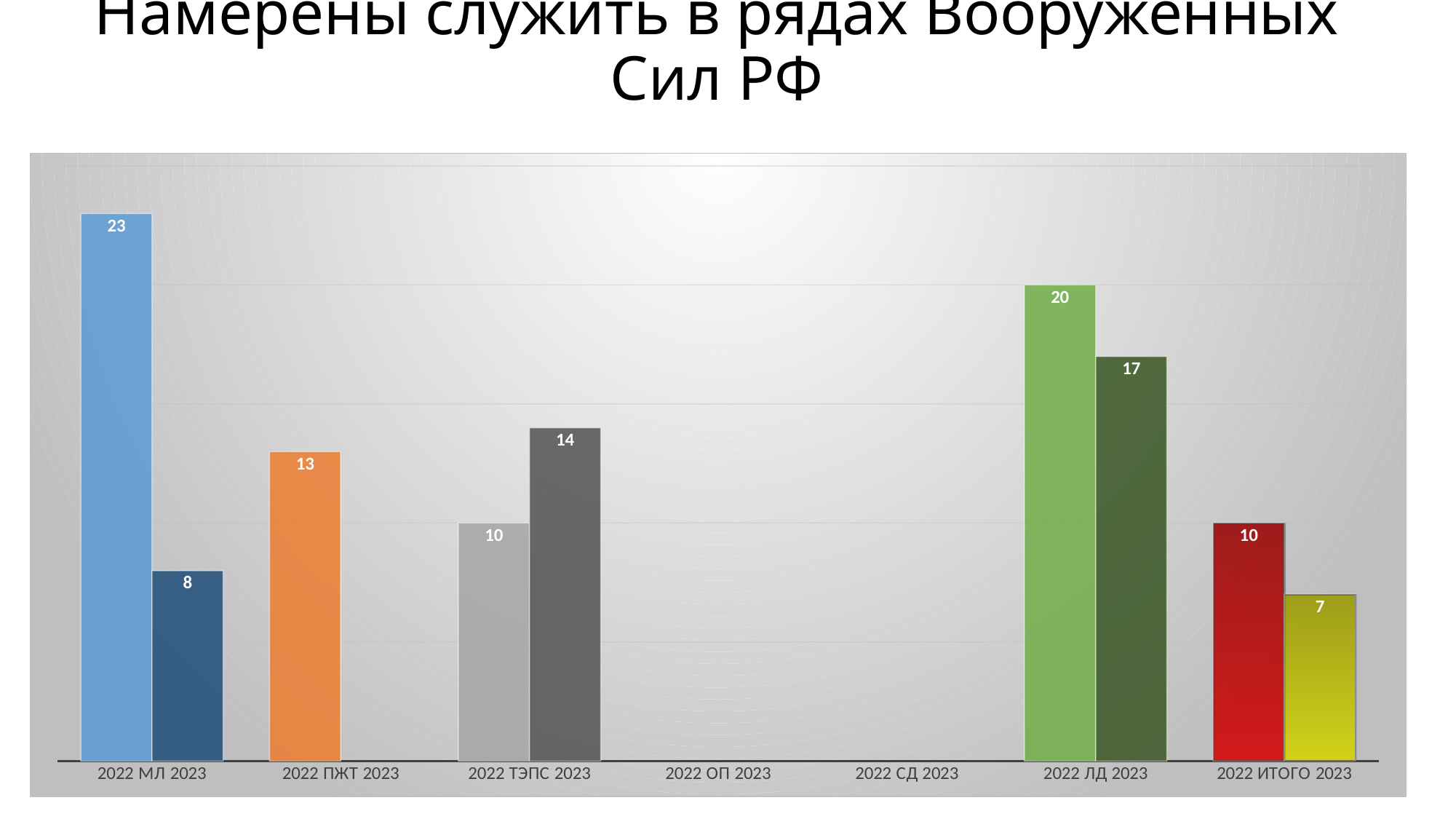
What kind of chart is shown on the slide? Bar chart What is the 2023 value for ТЭПС? 14 What is the 2023 value for ИТОГО? 7 What is the 2022 value for МЛ? 23 How many categories are labelled on the x axis? 7 What is the 2023 value for ЛД? 17 Which category has the highest 2022 value? МЛ What is the difference between the 2022 and 2023 values for МЛ? 15 What is the 2023 value for МЛ? 8 Which is larger for ТЭПС, the 2022 value or the 2023 value? 2023 What is the 2022 value for ПЖТ? 13 Which category has the lowest 2023 value among those with a 2023 bar? ИТОГО